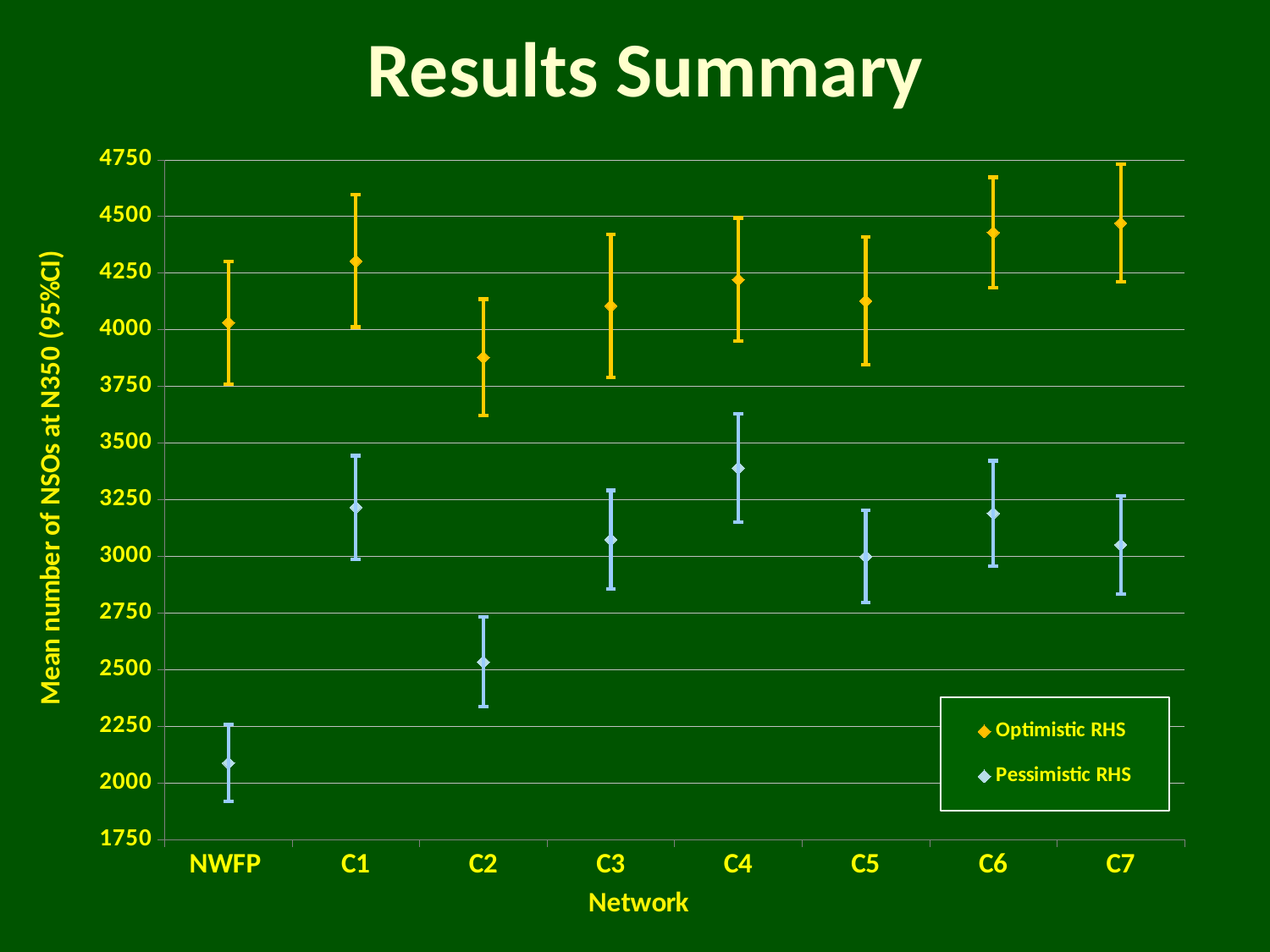
What kind of chart is shown on the slide? Scatter chart with error bars Which network has the lowest Optimistic RHS value? C2 Is the Pessimistic RHS value for C5 greater or less than 3250? less What is the title of the x axis of the chart? Network Is the Optimistic RHS value for C6 greater or less than 4250? greater Which network has the lowest Pessimistic RHS value? NWFP Which is larger for network C3: the Optimistic RHS value or the Pessimistic RHS value? Optimistic RHS How many series does the chart's legend list? 2 Is the Optimistic RHS value for C2 greater or less than 4000? less Which network has the highest Pessimistic RHS value? C4 How many networks are shown on the x axis of the chart? 8